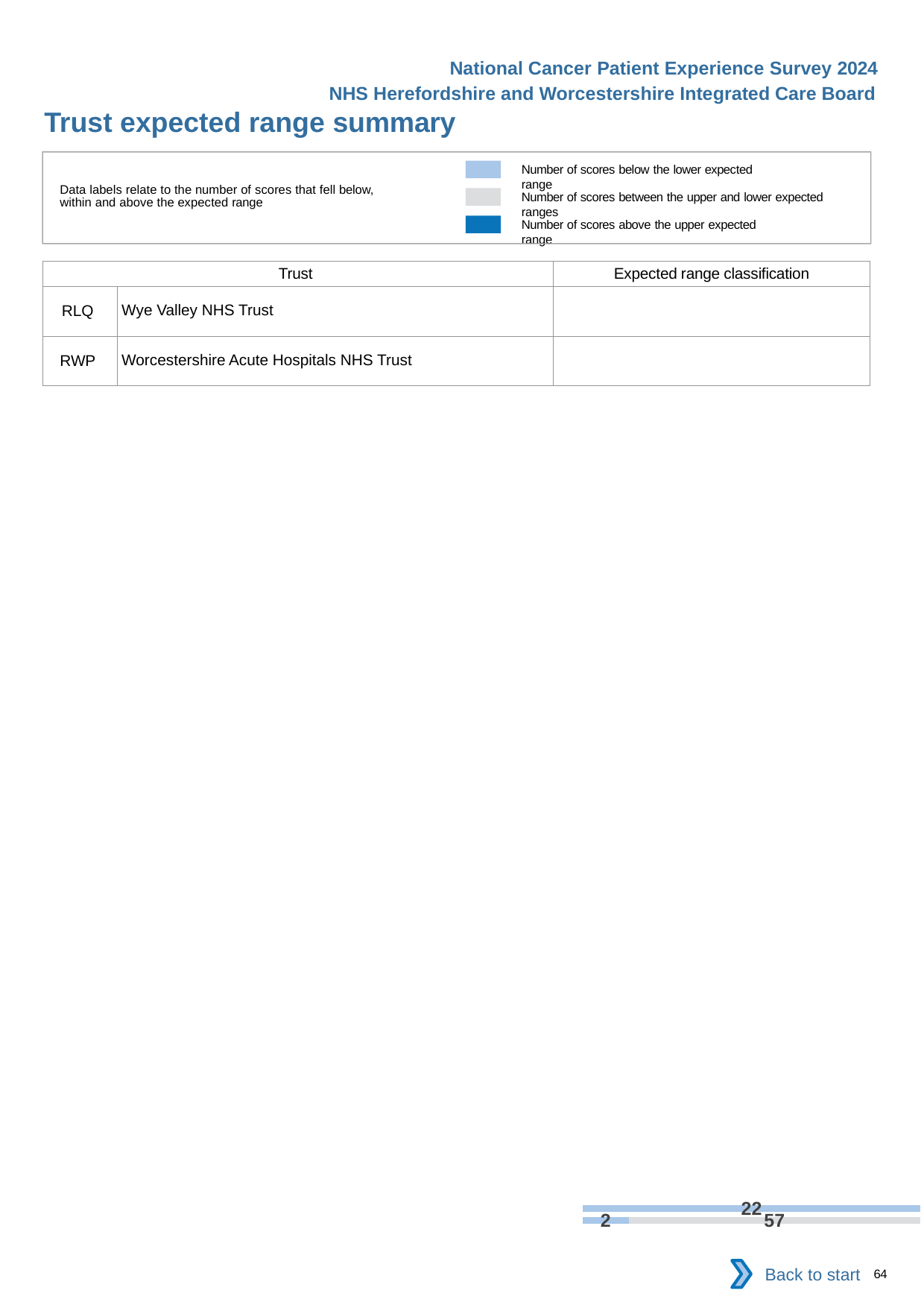
In the chart at the bottom right, what is the difference between the labelled values 57 and 22? 35 In the chart at the bottom right, which labelled value is larger: 22 on the top bar or 57 on the bottom bar? 57 According to the key, what does the light blue colour represent? Number of scores below the lower expected range How many entries does the colour key at the top of the slide list? 3 In the chart at the bottom right, what is the total of the two labelled segments of the bottom bar (2 and 57)? 59 According to the key, what does the dark blue colour represent? Number of scores above the upper expected range In the chart at the bottom right, what value is labelled on the top bar? 22 What kind of chart is shown at the bottom right of the slide? bar chart In the chart at the bottom right, what value is labelled on the light blue segment of the bottom bar? 2 In the chart at the bottom right, what value is labelled on the grey segment of the bottom bar? 57